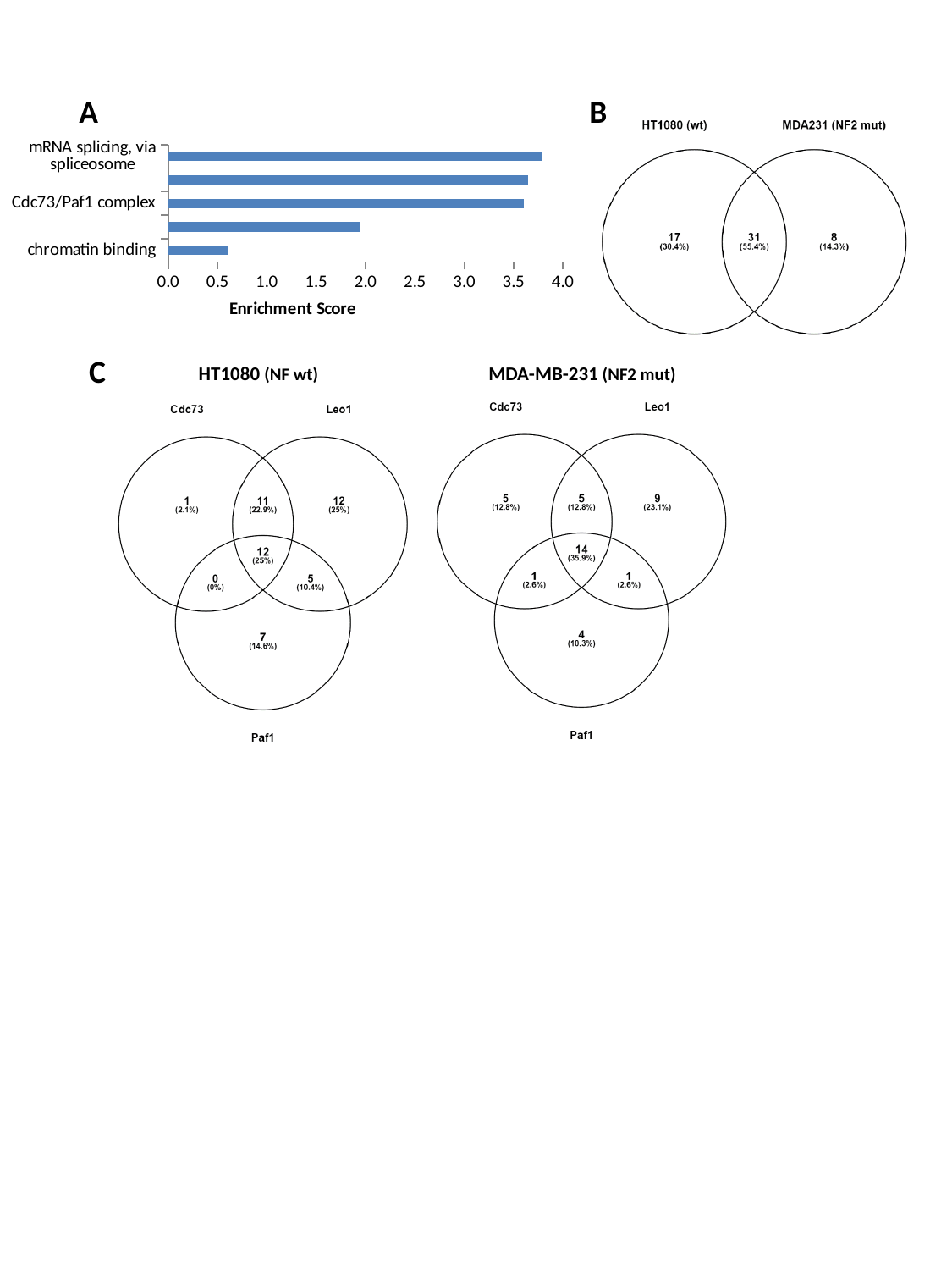
In the bar chart in panel A, is the enrichment score for Cdc73/Paf1 complex greater or less than 3.0? greater In the bar chart in panel A, which labelled category has the lowest enrichment score? chromatin binding In the MDA-MB-231 (NF2 mut) Venn diagram in panel C, how many items are shared by Cdc73, Leo1 and Paf1? 14 In the Venn diagram in panel B, what percentage is shown for the items unique to HT1080 (wt)? 30.4% In the bar chart in panel A, how many bars are plotted? 5 In the bar chart in panel A, which labelled category has the highest enrichment score? mRNA splicing, via spliceosome What kind of chart is panel A? bar chart In the bar chart in panel A, which has the larger enrichment score: Cdc73/Paf1 complex or chromatin binding? Cdc73/Paf1 complex In the bar chart in panel A, is the enrichment score for mRNA splicing, via spliceosome greater or less than 3.5? greater In the Venn diagram in panel B, how many items are shared between HT1080 (wt) and MDA231 (NF2 mut)? 31 In the bar chart in panel A, what is the x-axis title? Enrichment Score In the bar chart in panel A, is the enrichment score for chromatin binding greater or less than 1.0? less